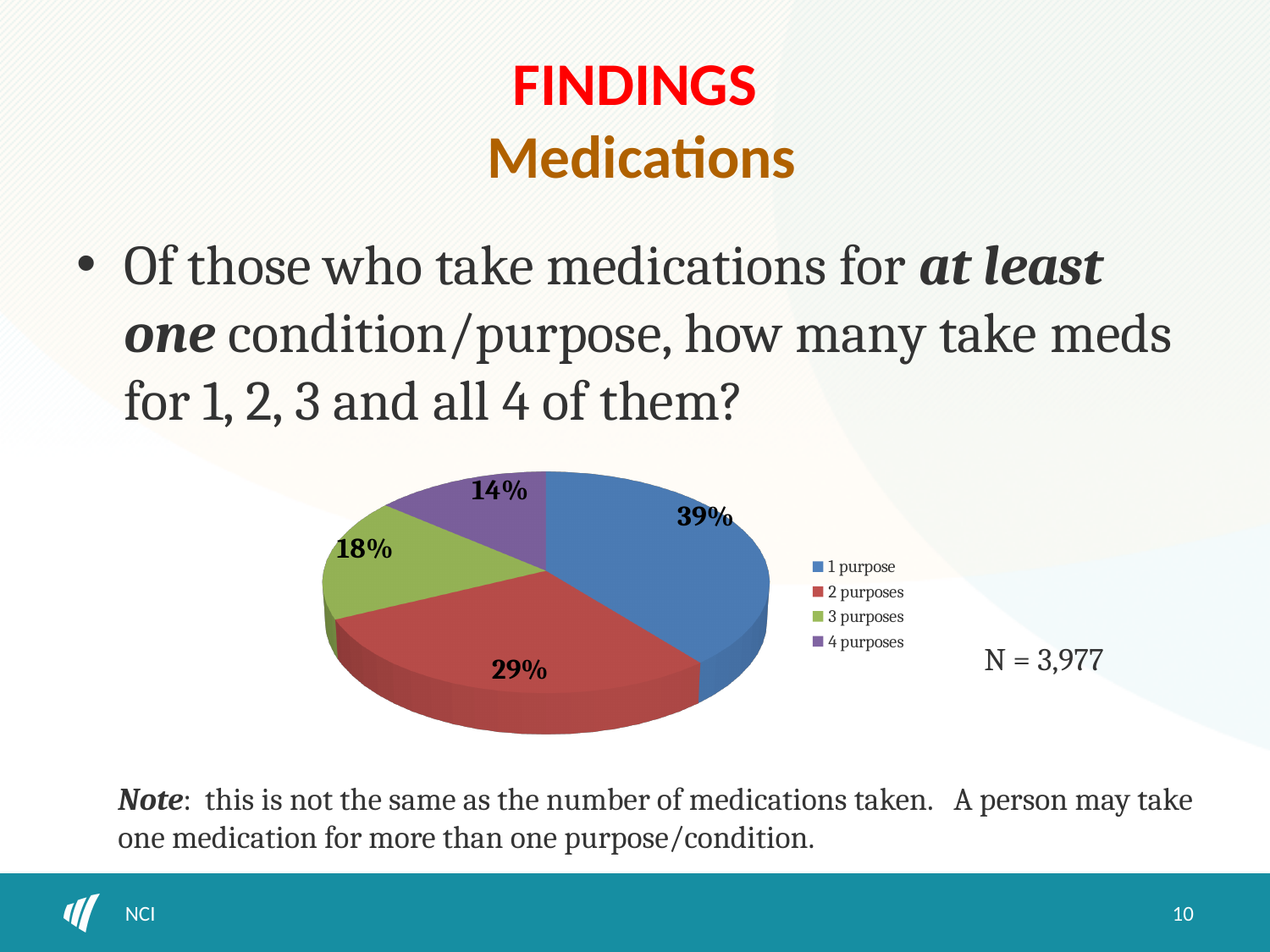
What percentage of the pie chart is for 1 purpose? 39% How many slices does the pie chart have? 4 What kind of chart is shown on the slide? Pie chart What percentage of the pie chart is for 2 purposes? 29% Which category has the largest share of the pie chart? 1 purpose What is the sample size (N) shown next to the pie chart? N = 3,977 What percentage of the pie chart is for 4 purposes? 14% Which category has the smallest share of the pie chart? 4 purposes Which slice is larger, 3 purposes or 4 purposes? 3 purposes What colour is the slice for 2 purposes? Red What is the difference in percentage points between the 1 purpose and 2 purposes slices? 10 What percentage of the pie chart is for 3 purposes? 18%